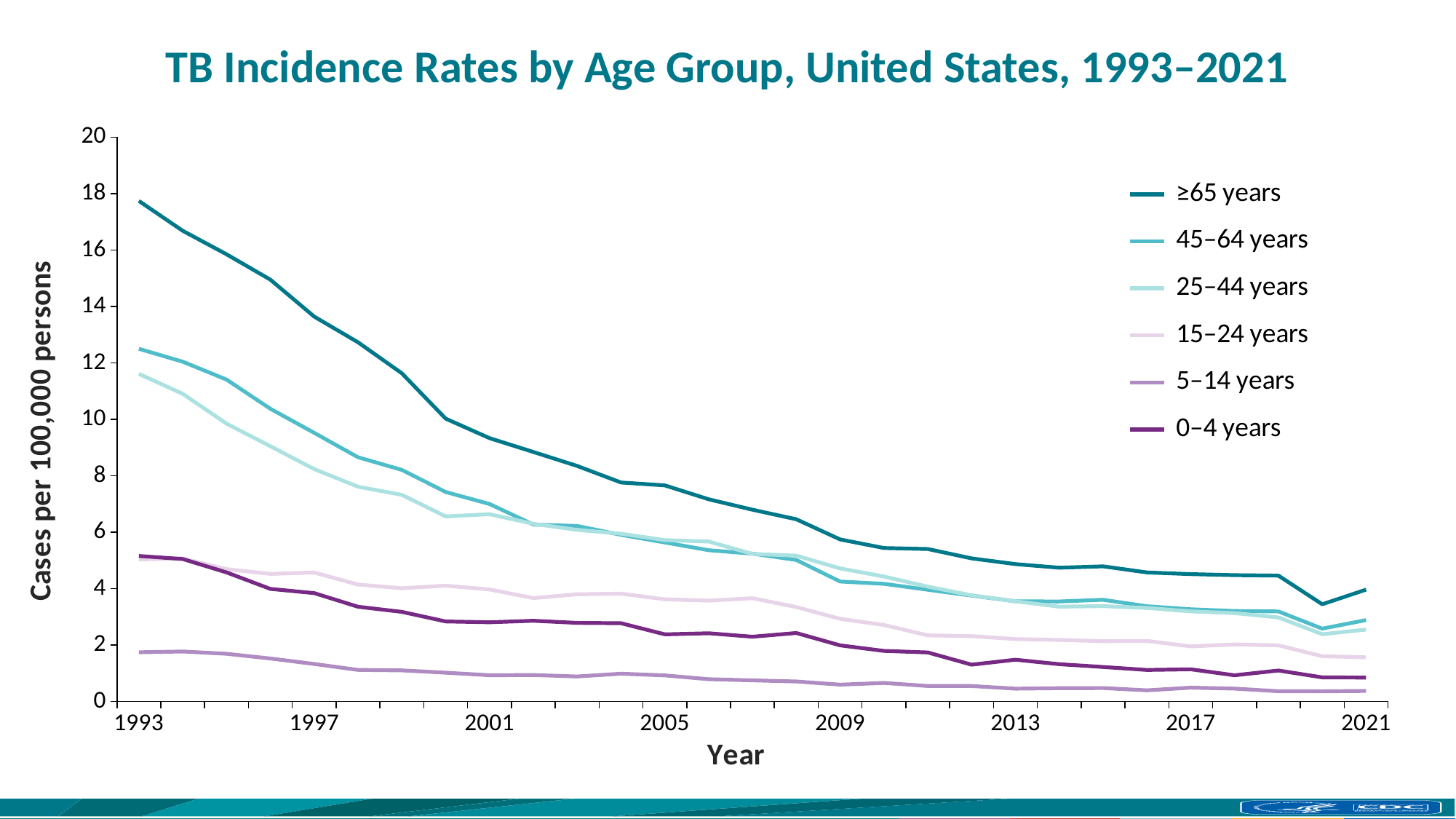
Is the value for 5–14 years in 1993 greater or less than 2? less Which age group has the highest TB incidence rate in 1993? ≥65 years Is the value for 25–44 years in 1993 greater or less than 10? greater Is the value for ≥65 years in 2021 greater or less than 6? less In 1993, which is larger: the value for 45–64 years or the value for 0–4 years? 45–64 years How many age groups does the legend list? 6 What kind of chart is shown on the slide? line chart Does the TB incidence rate for ≥65 years rise or fall from 1993 to 2021? fall What is the title of the chart? TB Incidence Rates by Age Group, United States, 1993–2021 Which age group has the lowest TB incidence rate in 1993? 5–14 years What is the label of the vertical axis? Cases per 100,000 persons